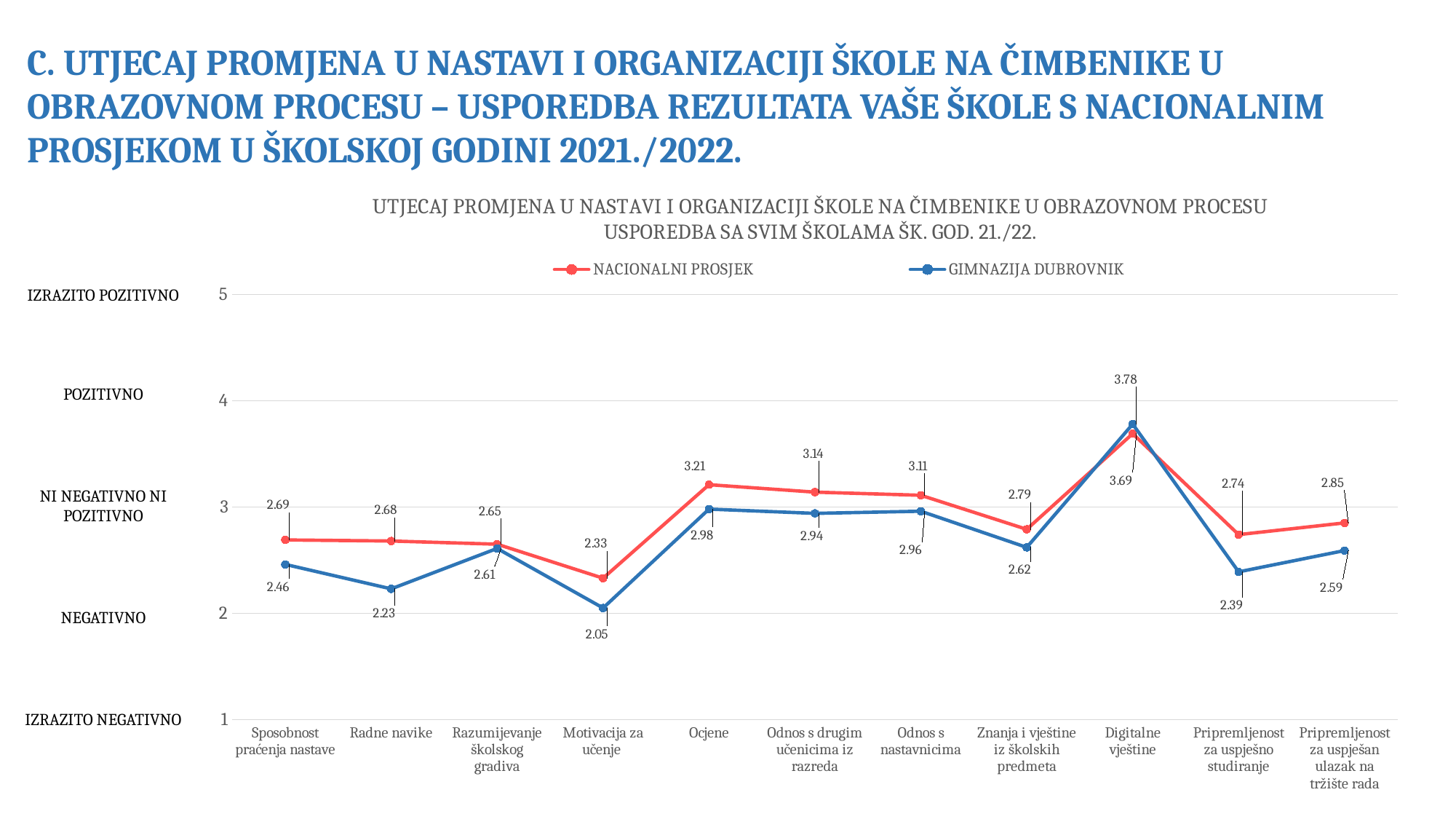
How many categories are shown on the x axis? 11 What type of chart is shown on the slide? line chart Which category has the highest value for NACIONALNI PROSJEK? Digitalne vještine What is the value for GIMNAZIJA DUBROVNIK for Motivacija za učenje? 2.05 Is the value for GIMNAZIJA DUBROVNIK for Radne navike greater or less than 3? less What is the value for GIMNAZIJA DUBROVNIK for Digitalne vještine? 3.78 Which category has the lowest value for GIMNAZIJA DUBROVNIK? Motivacija za učenje What is the value for NACIONALNI PROSJEK for Ocjene? 3.21 Which colour is used for the NACIONALNI PROSJEK series? red For Digitalne vještine, which series has the larger value, NACIONALNI PROSJEK or GIMNAZIJA DUBROVNIK? GIMNAZIJA DUBROVNIK How many series does the legend list? 2 What is the difference between NACIONALNI PROSJEK and GIMNAZIJA DUBROVNIK for Pripremljenost za uspješno studiranje? 0.35